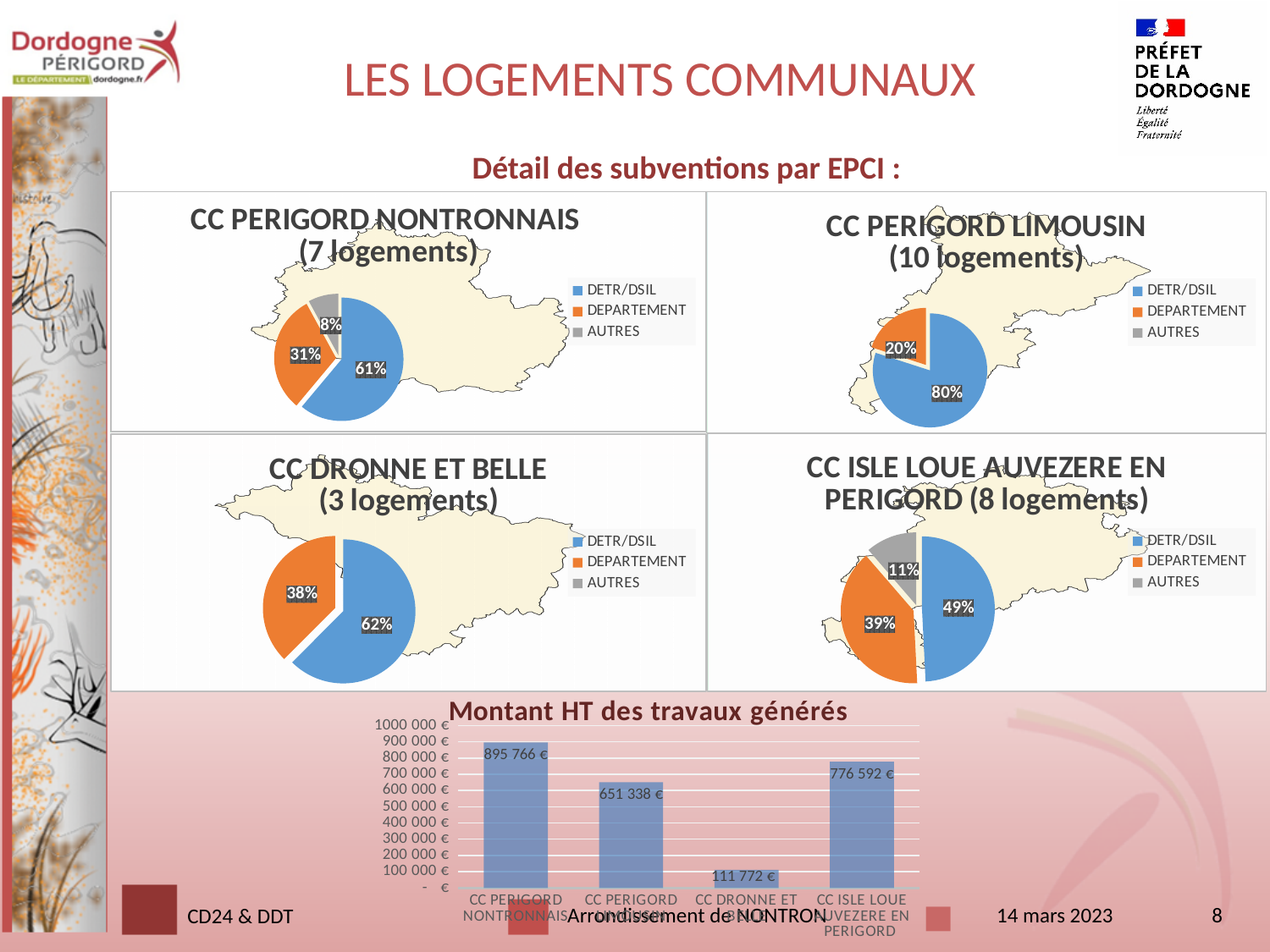
How many entries does the legend of the CC DRONNE ET BELLE pie chart list? 3 In the 'Montant HT des travaux générés' chart, which category has the lowest value? CC DRONNE ET BELLE In the CC ISLE LOUE AUVEZERE EN PERIGORD pie chart, which category has the smallest share? AUTRES In the CC PERIGORD NONTRONNAIS pie chart, what share does AUTRES represent? 8% What kind of chart is 'Montant HT des travaux générés'? Bar chart In the 'Montant HT des travaux générés' chart, what is the value for CC PERIGORD NONTRONNAIS? 895 766 € In the CC ISLE LOUE AUVEZERE EN PERIGORD pie chart, what share does DETR/DSIL represent? 49% In the CC PERIGORD LIMOUSIN pie chart, what share does DEPARTEMENT represent? 20% In the 'Montant HT des travaux générés' chart, what is the difference between CC ISLE LOUE AUVEZERE EN PERIGORD and CC PERIGORD LIMOUSIN? 125 254 € In the CC PERIGORD LIMOUSIN pie chart, which category has the largest share? DETR/DSIL